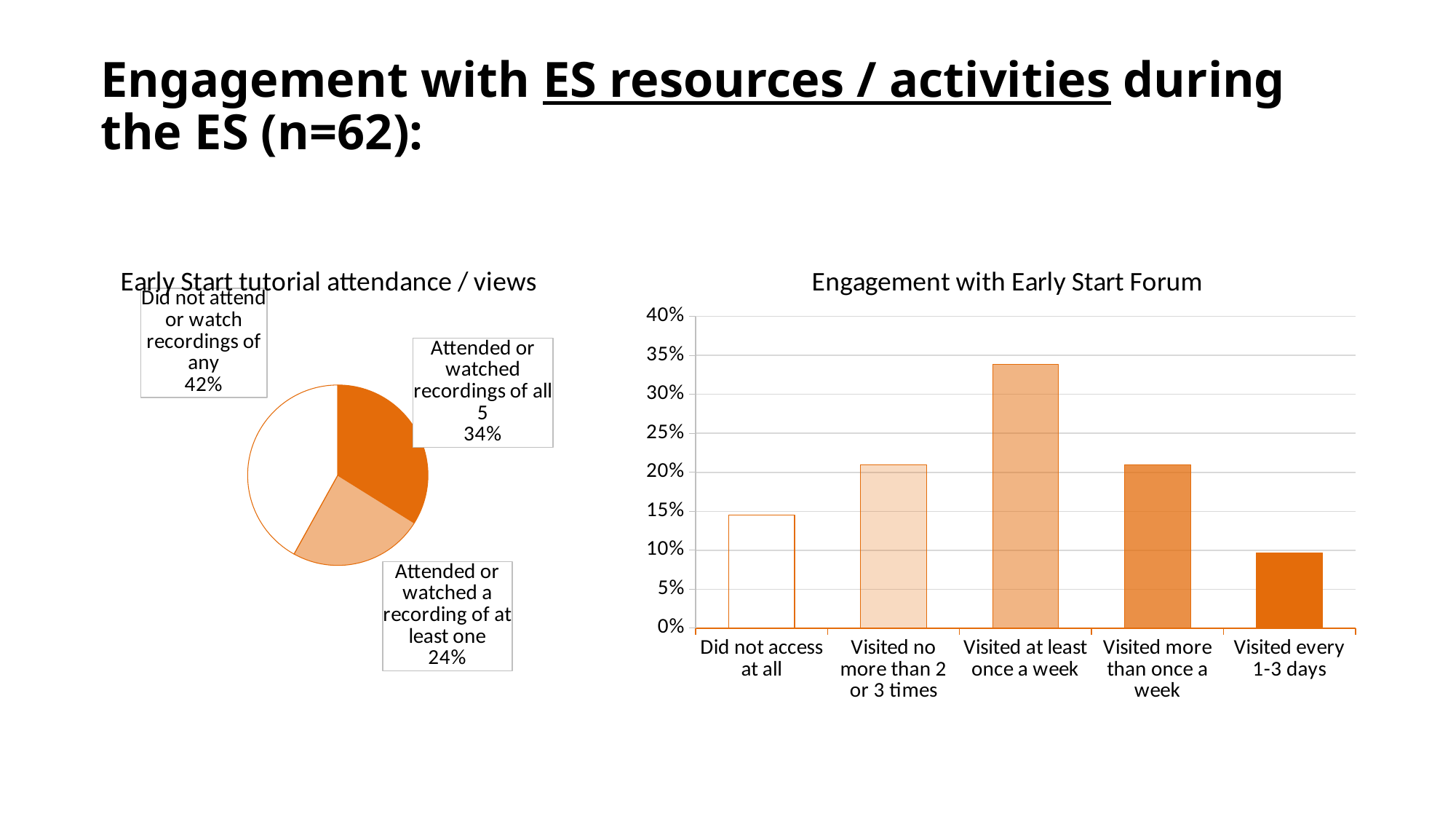
How many slices does the 'Early Start tutorial attendance / views' pie chart have? 3 How many categories are shown on the x axis of the 'Engagement with Early Start Forum' chart? 5 In the 'Early Start tutorial attendance / views' pie chart, what share of respondents did not attend or watch recordings of any tutorial? 42% What kind of chart is 'Early Start tutorial attendance / views'? Pie chart In the 'Early Start tutorial attendance / views' pie chart, how many percentage points larger is 'Did not attend or watch recordings of any' than 'Attended or watched recordings of all 5'? 8 percentage points In the 'Engagement with Early Start Forum' chart, is the value for 'Visited every 1-3 days' greater or less than 15%? less In the 'Engagement with Early Start Forum' chart, which category has the lowest value? Visited every 1-3 days In the 'Early Start tutorial attendance / views' pie chart, what share attended or watched a recording of at least one? 24% In the 'Early Start tutorial attendance / views' pie chart, which category has the largest slice? Did not attend or watch recordings of any In the 'Engagement with Early Start Forum' chart, which category has the highest value? Visited at least once a week In the 'Engagement with Early Start Forum' chart, is the value for 'Visited at least once a week' greater or less than 30%? greater In the 'Early Start tutorial attendance / views' pie chart, what share attended or watched recordings of all 5? 34%